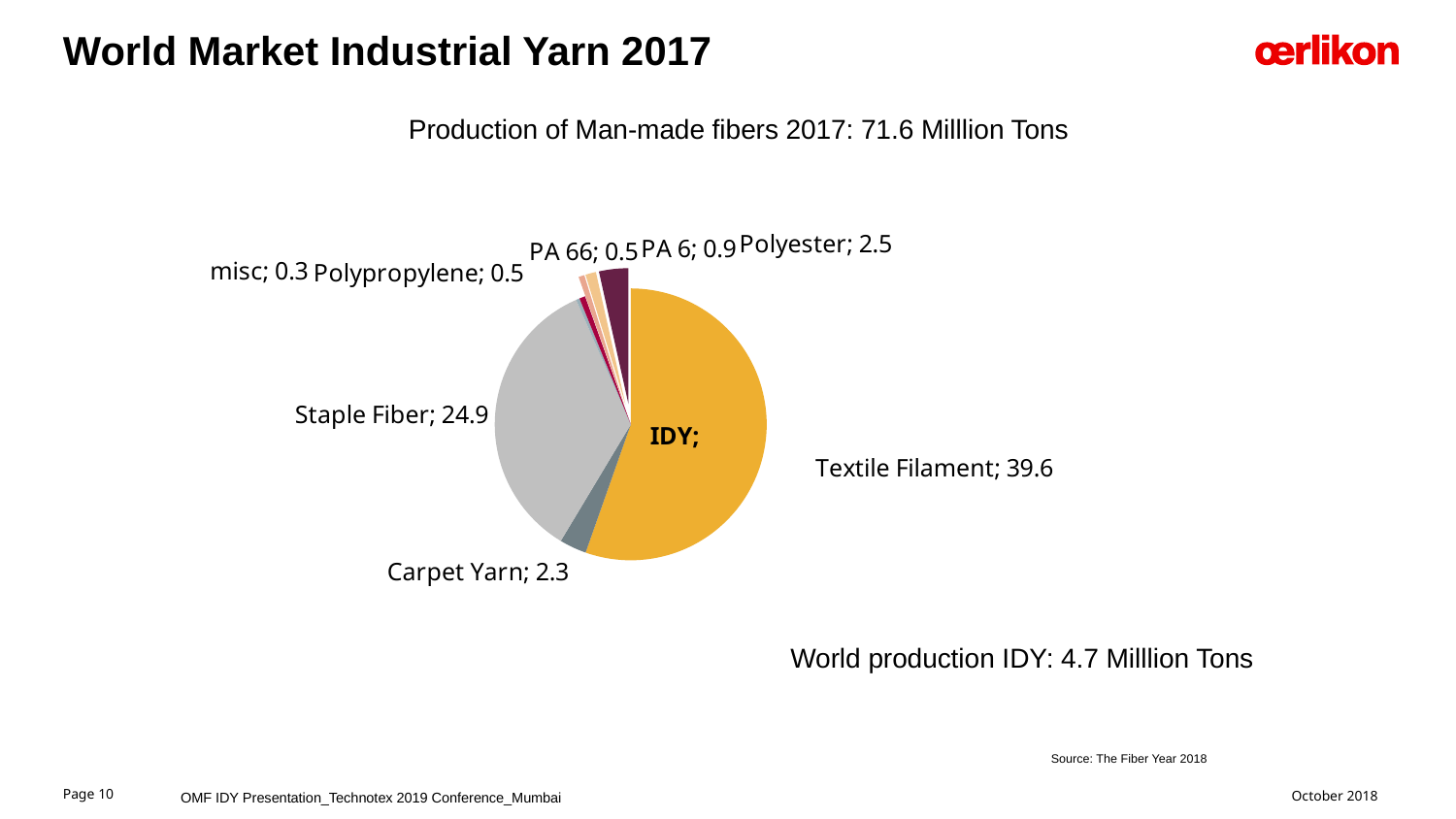
What is the value shown for Textile Filament in the pie chart? 39.6 What is the difference between the values for Staple Fiber and Carpet Yarn? 22.6 Which labelled category has the smallest value in the pie chart? misc What is the value shown for Carpet Yarn in the pie chart? 2.3 What is the difference between the values for Textile Filament and Staple Fiber? 14.7 Which category has the largest slice in the pie chart? Textile Filament What kind of chart is shown on the slide? Pie chart What is the title printed above the pie chart? Production of Man-made fibers 2017: 71.6 Milllion Tons What is the value shown for Staple Fiber in the pie chart? 24.9 Which is larger, the value for PA 6 or the value for PA 66? PA 6 What is the value shown for Polyester in the pie chart? 2.5 What is the value shown for PA 6 in the pie chart? 0.9